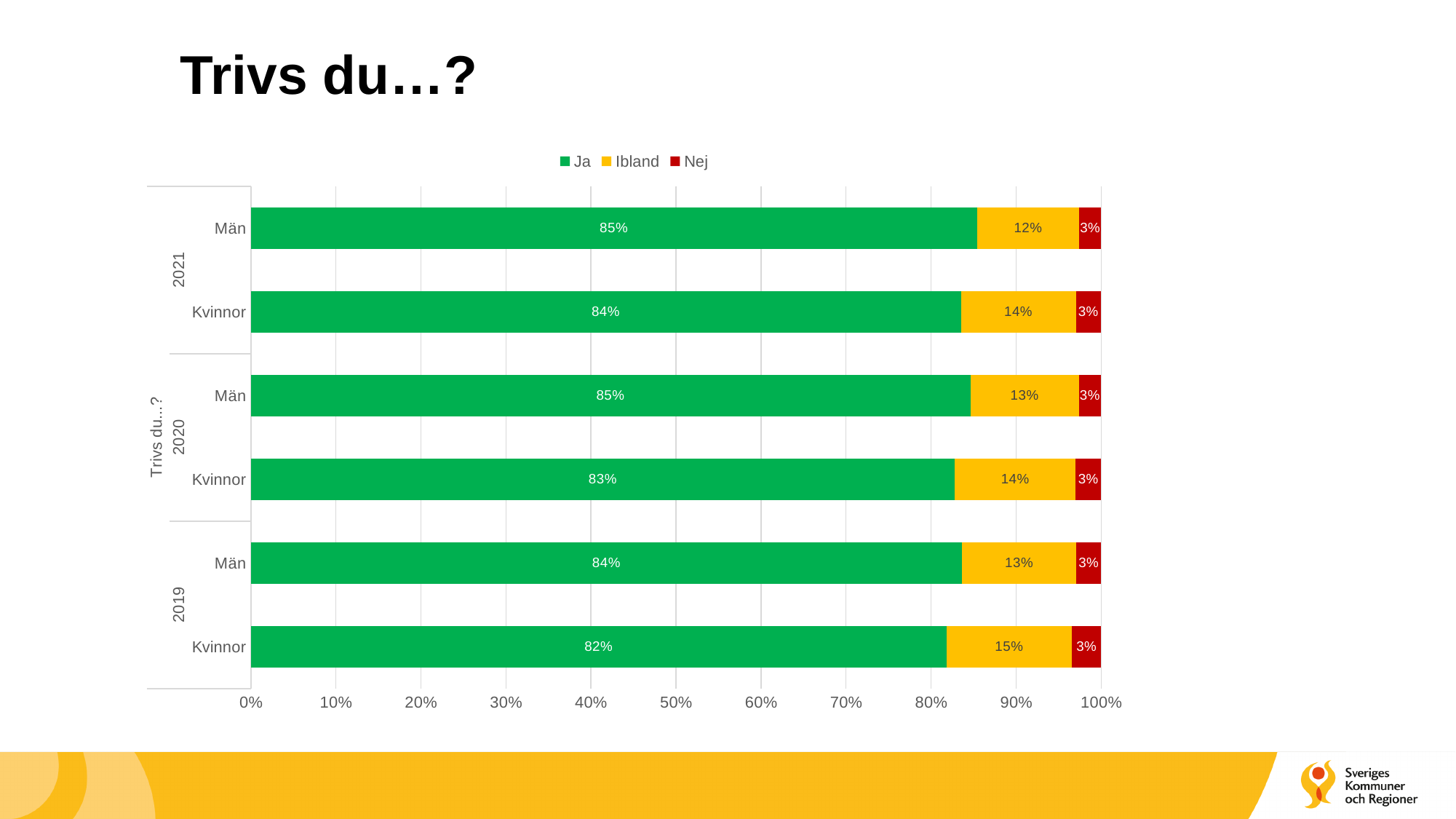
Which group and year has the highest "Ibland" share? Kvinnor 2019 What percentage of women (Kvinnor) answered "Ja" in 2020? 83% Which group and year has the lowest "Ibland" share? Män 2021 Which group and year has the lowest "Ja" share? Kvinnor 2019 What type of chart is shown on the slide? Stacked bar chart Which is larger: the "Ja" share for Kvinnor in 2021 or for Kvinnor in 2020? Kvinnor 2021 What percentage of men (Män) answered "Ja" in 2021? 85% What is the difference in percentage points between the "Ja" share for Män 2021 and Kvinnor 2019? 3 percentage points How many bars are shown in the chart? 6 How many series does the legend list? 3 What percentage of men (Män) answered "Nej" in 2020? 3% What percentage of women (Kvinnor) answered "Ibland" in 2019? 15%